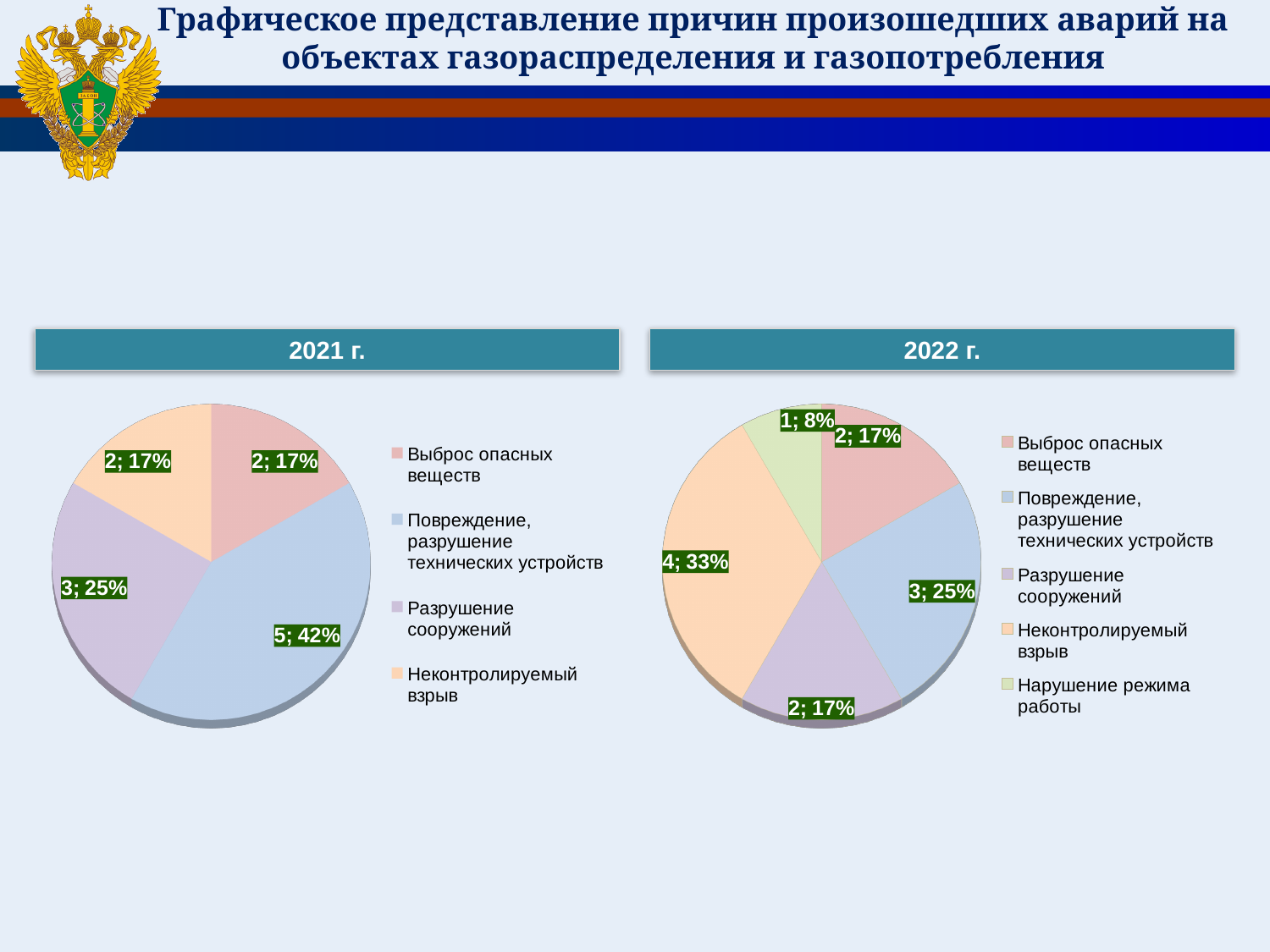
What type of chart is used for 2021 г. and 2022 г.? Pie chart In the 2022 г. pie chart, what is the data label for Неконтролируемый взрыв? 4; 33% In the 2022 г. pie chart, which category has the smallest slice? Нарушение режима работы In the 2021 г. pie chart, what share does Разрушение сооружений have? 25% How many slices does the 2021 г. pie chart have? 4 In the 2022 г. pie chart, what share does Повреждение, разрушение технических устройств have? 25% In the 2021 г. pie chart, which category has the largest slice? Повреждение, разрушение технических устройств What is the difference in count between Повреждение, разрушение технических устройств in 2021 г. and in 2022 г.? 2 How many categories does the legend of the 2022 г. pie chart list? 5 In the 2021 г. pie chart, what is the data label for Повреждение, разрушение технических устройств? 5; 42% In the 2022 г. pie chart, what colour is the Нарушение режима работы slice? Light green In the 2022 г. pie chart, which is larger: Неконтролируемый взрыв or Выброс опасных веществ? Неконтролируемый взрыв